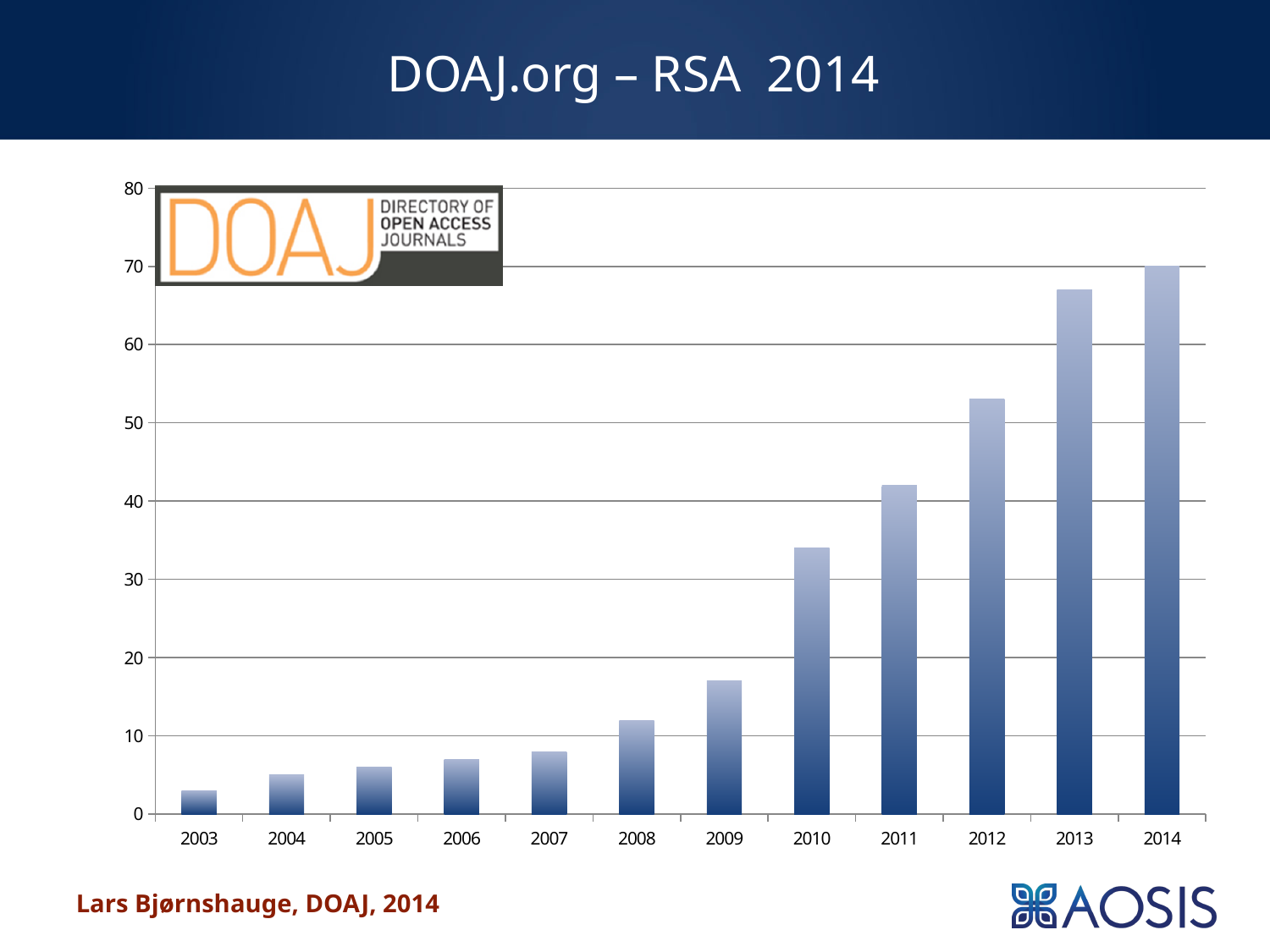
Which year has the highest bar in the chart? 2014 How many years are shown on the x axis of the chart? 12 Which is larger, the value for 2013 or the value for 2012? 2013 Which is larger, the value for 2011 or the value for 2008? 2011 Is the value for 2012 greater or less than 50? greater Is the value for 2009 greater or less than 20? less Do the values rise or fall from 2003 to 2014? rise Which year has the lowest bar in the chart? 2003 Is the value for 2010 greater or less than 30? greater What is the value for 2014 in the chart? 70 What is the title of the slide containing the chart? DOAJ.org – RSA 2014 What kind of chart is shown on the slide? bar chart